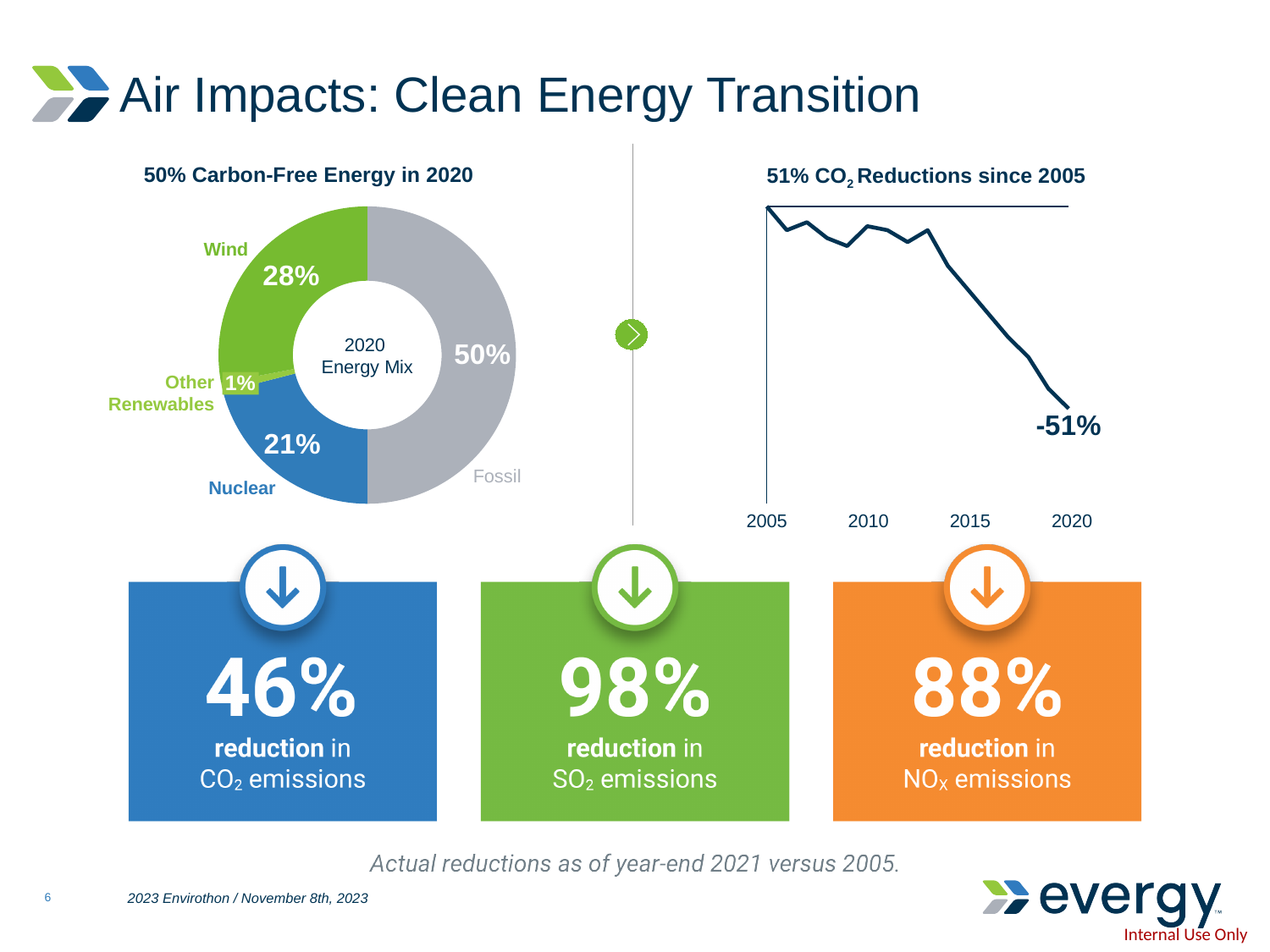
In the "50% Carbon-Free Energy in 2020" chart, what share of the 2020 energy mix is Fossil? 50% In the "50% Carbon-Free Energy in 2020" chart, which is larger, the Wind share or the Nuclear share? Wind In the "50% Carbon-Free Energy in 2020" chart, what share of the 2020 energy mix is Nuclear? 21% In the "50% Carbon-Free Energy in 2020" chart, what share of the 2020 energy mix is Other Renewables? 1% In the "50% Carbon-Free Energy in 2020" chart, what share of the 2020 energy mix is Wind? 28% In the "51% CO2 Reductions since 2005" chart, what value is labelled at the end of the line in 2020? -51% How many energy sources are shown in the "50% Carbon-Free Energy in 2020" chart? 4 In the "51% CO2 Reductions since 2005" chart, does the line rise or fall from 2005 to 2020? Fall In the "50% Carbon-Free Energy in 2020" chart, which energy source has the smallest share? Other Renewables In the "50% Carbon-Free Energy in 2020" chart, how many percentage points larger is the Wind share than the Nuclear share? 7% What kind of chart is the "50% Carbon-Free Energy in 2020" chart? Donut (pie) chart In the "50% Carbon-Free Energy in 2020" chart, which energy source has the largest share? Fossil